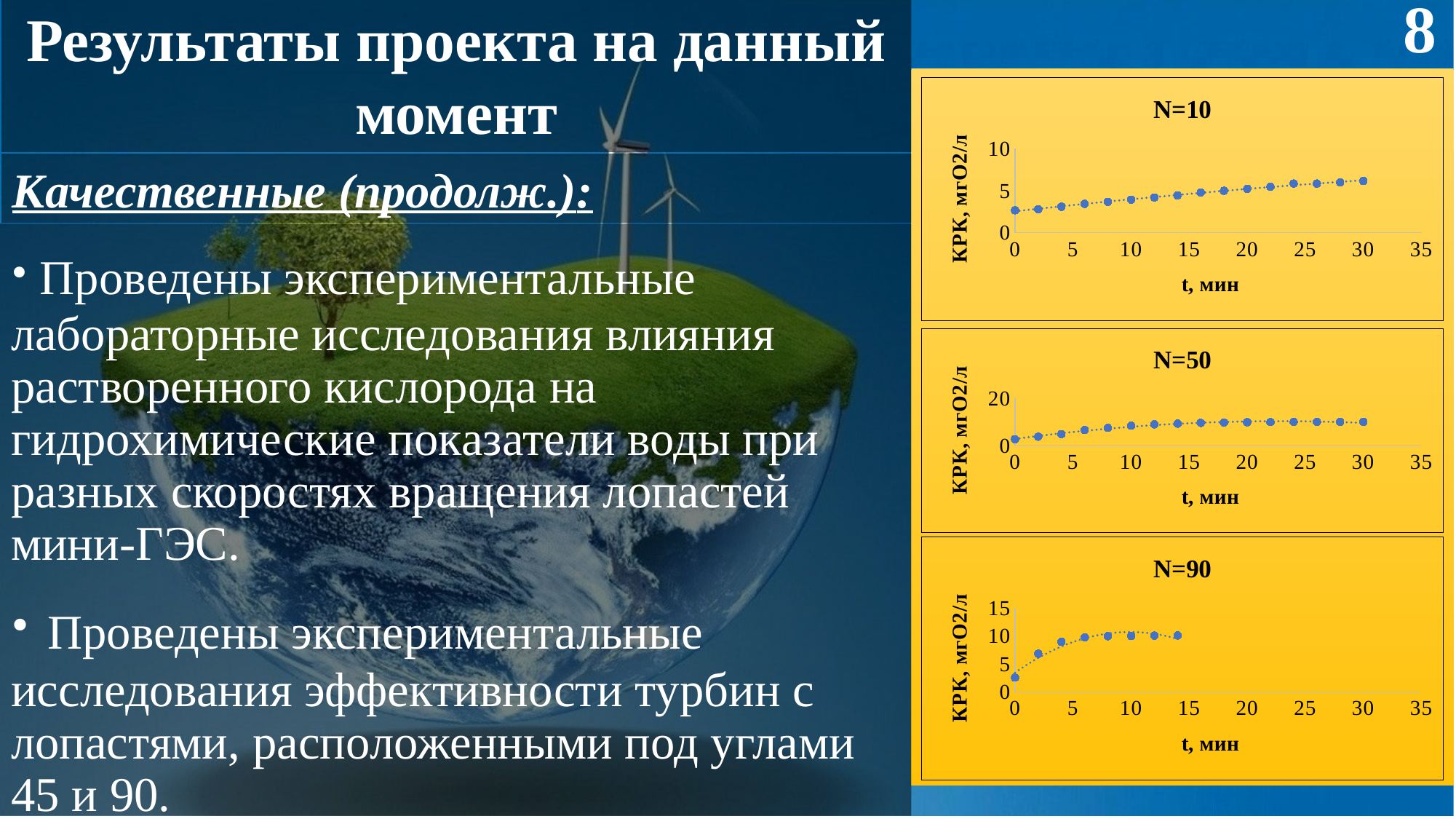
In the N=50 chart, is the value at t=30 greater or less than 20? less In the N=90 chart, is the value at t=10 greater or less than 5? greater In the N=10 chart, do the values rise or fall as t increases? rise In the N=50 chart, do the values rise or fall as t increases from 0 to 30? rise In the N=10 chart, is the value at t=0 greater or less than 5? less What is the y-axis label of the N=90 chart? КРК, мгО2/л What kind of chart is the N=10 chart? scatter chart What is the largest tick value on the x axis of the N=50 chart? 35 How many data points are plotted in the N=90 chart? 8